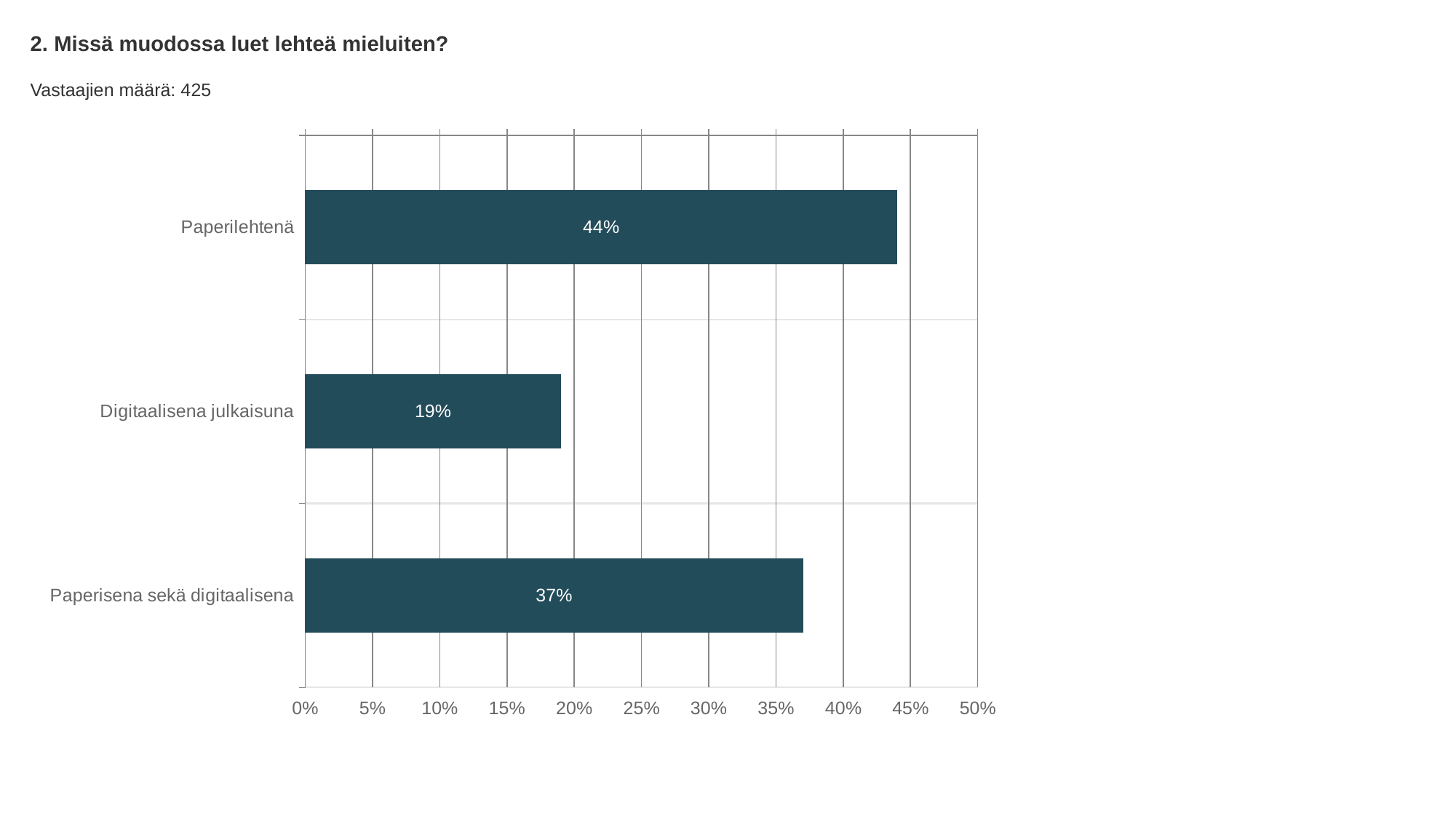
Is the value for Paperilehtenä greater or less than 40%? greater What is the title of the chart? 2. Missä muodossa luet lehteä mieluiten? How many categories are shown in the chart? 3 What is the value for Paperilehtenä? 44% What is the difference between the values for Paperilehtenä and Paperisena sekä digitaalisena? 7% Which category has the lowest value? Digitaalisena julkaisuna What kind of chart is shown on the slide? bar chart What is the difference between the values for Paperisena sekä digitaalisena and Digitaalisena julkaisuna? 18% Which category has the highest value? Paperilehtenä Which is larger, the value for Digitaalisena julkaisuna or the value for Paperisena sekä digitaalisena? Paperisena sekä digitaalisena What is the value for Paperisena sekä digitaalisena? 37% What is the value for Digitaalisena julkaisuna? 19%